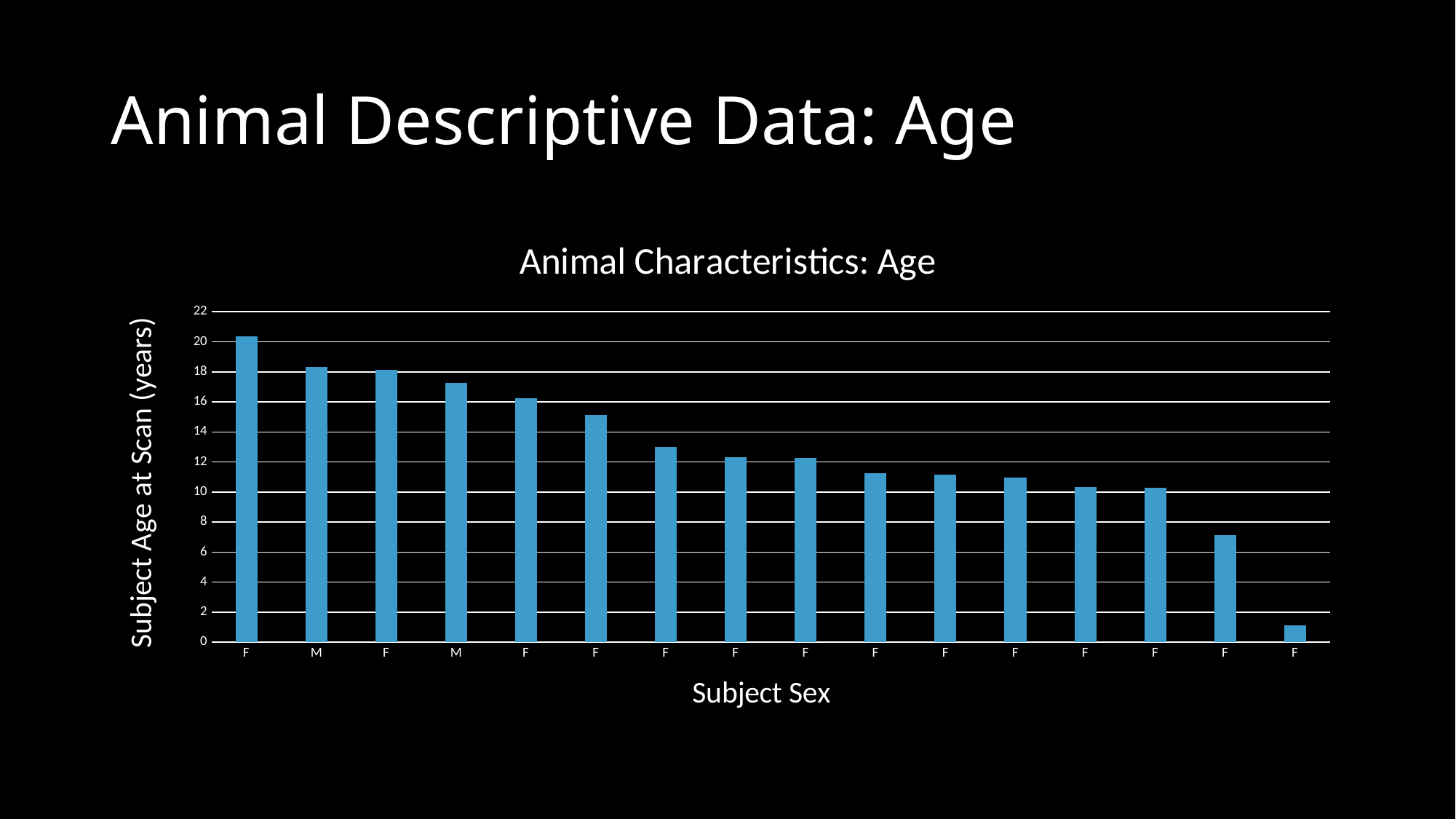
How many bars are plotted in the chart? 16 Is the value for the second bar from the right greater or less than 8? less Is the value for the leftmost bar greater or less than 18? greater Is the value for the rightmost bar greater or less than 2? less Which bar has the lowest value? the rightmost bar (F) What kind of chart is shown on the slide? bar chart How many bars are labelled M on the x axis? 2 Which bar has the highest value? the leftmost bar (F) What is the title of the chart? Animal Characteristics: Age Which of the two M bars is taller, the first M bar or the second M bar? the first M bar Do the values rise or fall from left to right along the x axis? fall